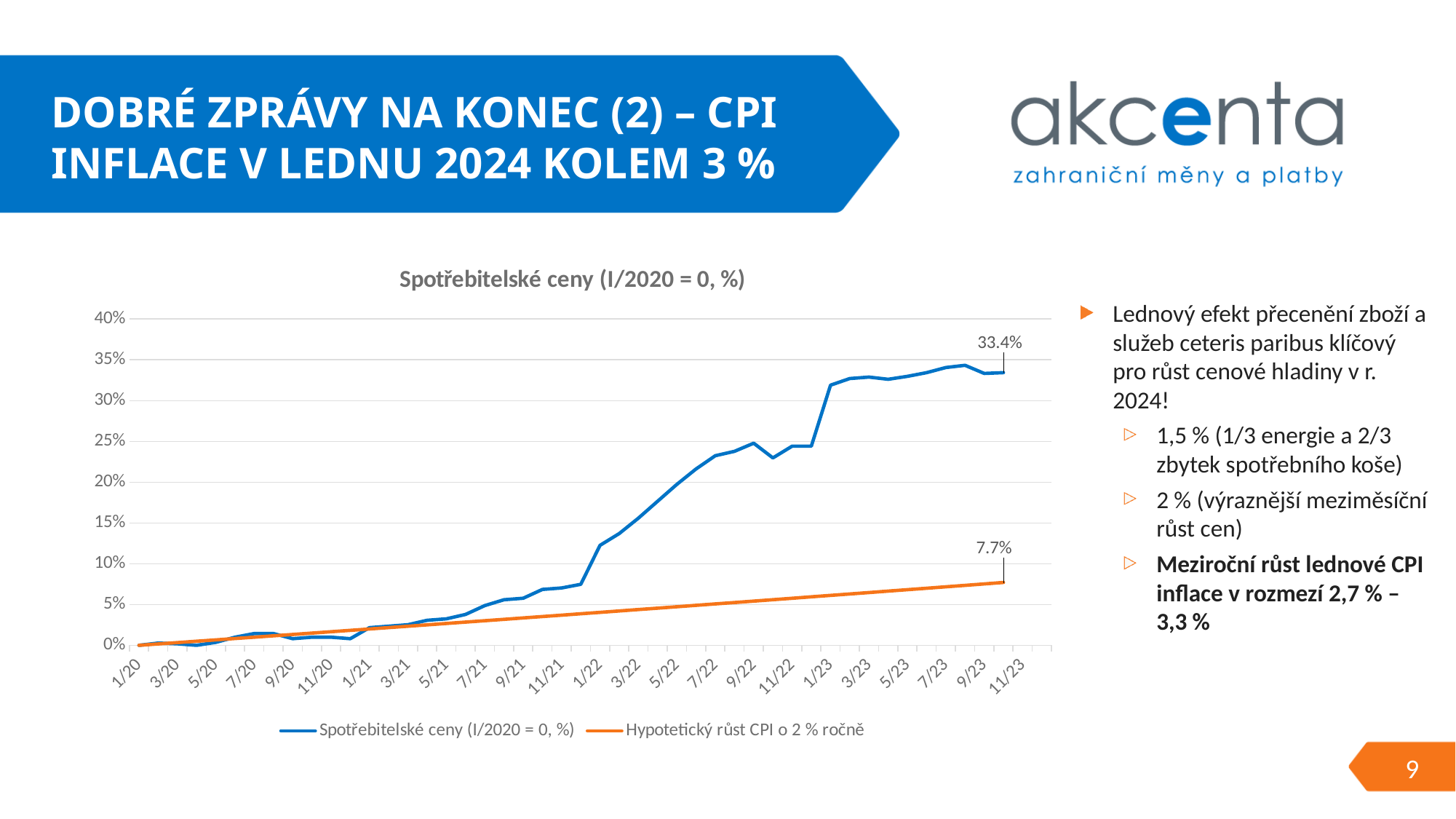
What is the labelled value of the Hypotetický růst CPI o 2 % ročně series at the end of the chart (11/23)? 7.7% What is the labelled value of the Spotřebitelské ceny (I/2020 = 0, %) series at the end of the chart (11/23)? 33.4% Which series is drawn in orange? Hypotetický růst CPI o 2 % ročně How many series does the chart legend list? 2 What kind of chart is shown on the slide? line chart Does the Spotřebitelské ceny series generally rise or fall from 1/20 to 11/23? rise Is the value of the Spotřebitelské ceny series at 9/21 greater or less than 10%? less Is the value of the Spotřebitelské ceny series at 7/22 greater or less than 20%? greater What is the title of the chart? Spotřebitelské ceny (I/2020 = 0, %) Is the value of the Hypotetický růst CPI o 2 % ročně series at 1/22 greater or less than 5%? less What is the difference between the final labelled values of the two series (33.4% and 7.7%)? 25.7% Which series ends at a higher value in 11/23: Spotřebitelské ceny or Hypotetický růst CPI o 2 % ročně? Spotřebitelské ceny